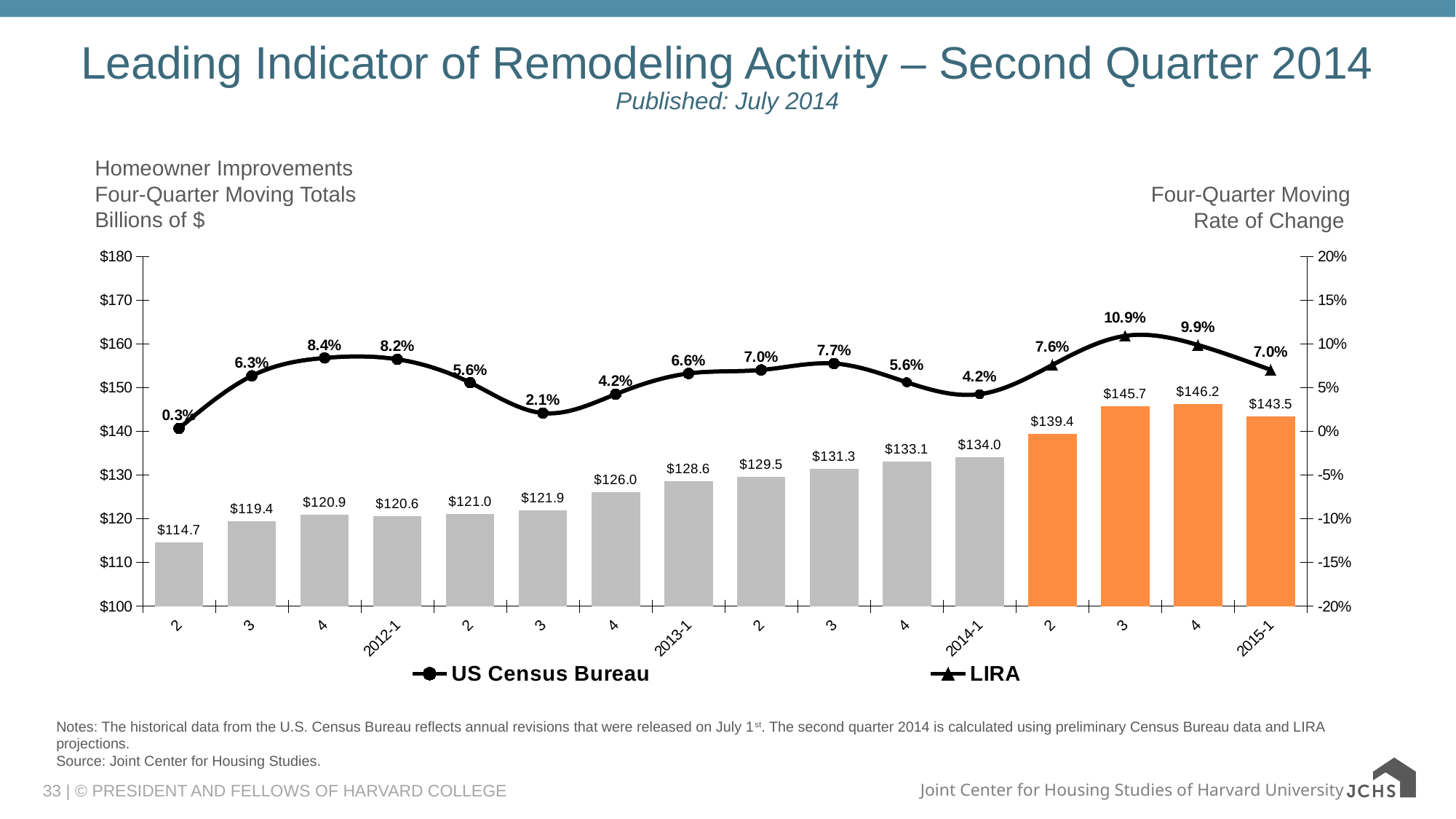
How many series does the legend list? 2 What is the four-quarter moving total shown for 2012-1? $120.6 Which has a larger four-quarter moving total, 2013-1 or 2012-1? 2013-1 What is the four-quarter moving total (billions of $) shown for 2014-1? $134.0 What is the lowest four-quarter moving total value labeled on any bar? $114.7 Do the four-quarter moving totals generally rise or fall from left to right across the chart? rise What four-quarter moving rate of change is shown for 2015-1? 7.0% What is the lowest four-quarter moving rate of change labeled on the line? 0.3% By how much does the four-quarter moving total for 2015-1 exceed that for 2014-1? $9.5 How many bars are plotted in the chart? 16 What is the highest four-quarter moving total value labeled on any bar? $146.2 What is the highest four-quarter moving rate of change labeled on the line? 10.9%